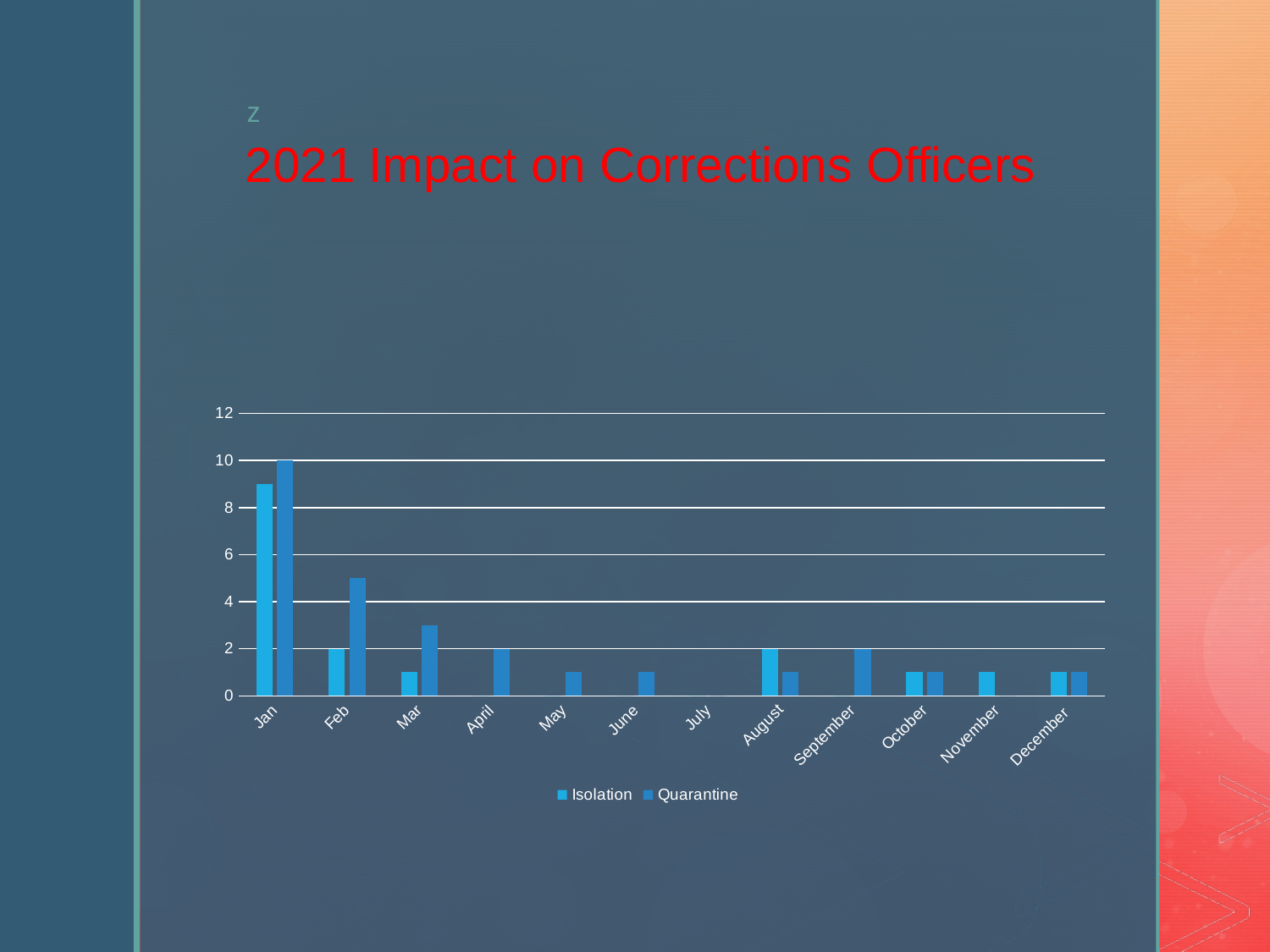
Which month has the highest Quarantine value? Jan What is the Quarantine value for Jan? 10 In Feb, which is larger, Isolation or Quarantine? Quarantine Is the Quarantine value for Mar greater or less than 4? less Is the Isolation value for Jan greater or less than 8? greater What is the Quarantine value for September? 2 Do the Quarantine values rise or fall from Jan to Mar? fall What is the Isolation value for Feb? 2 Is the Quarantine value for Feb greater or less than 4? greater How many series does the legend list? 2 How many months are shown on the x axis? 12 What kind of chart is shown on the slide? bar chart